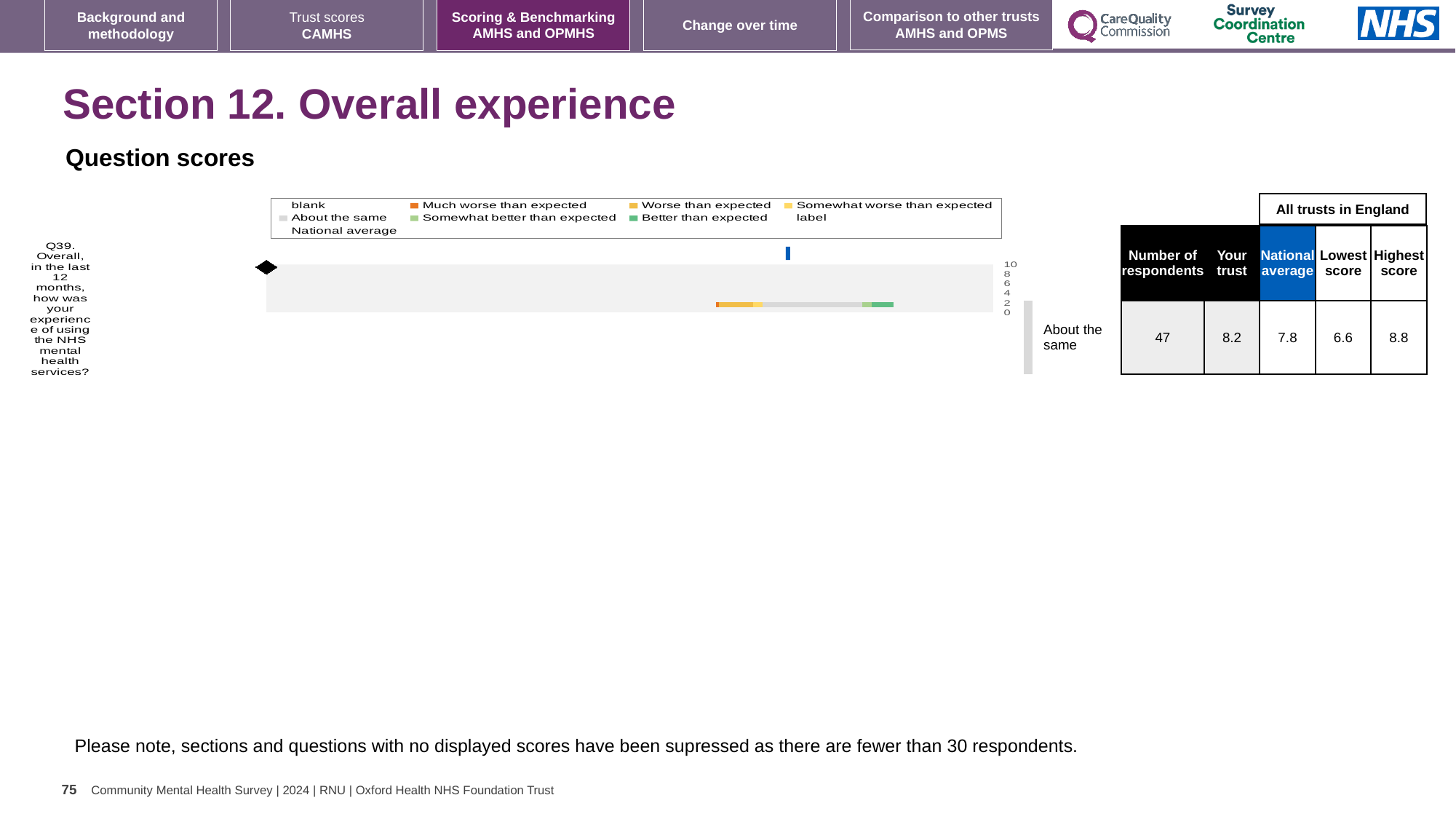
Which question number is plotted in the chart? Q39 What is the difference between the highest score and the lowest score for Q39 shown in the table? 2.2 Is the trust's score for Q39 higher or lower than the national average? higher According to the table beside the chart, what is the national average score for Q39? 7.8 According to the table beside the chart, what is the lowest score among all trusts in England for Q39? 6.6 According to the table beside the chart, how many respondents answered Q39? 47 What kind of chart is shown on the slide? bar chart According to the table beside the chart, what is the highest score among all trusts in England for Q39? 8.8 What is the highest tick value shown on the chart's score axis? 10 According to the table beside the chart, what is the trust's score for Q39? 8.2 How many questions (categories) are plotted in the chart? 1 Which benchmarking band is the trust's score for Q39 placed in, according to the label beside the chart? About the same